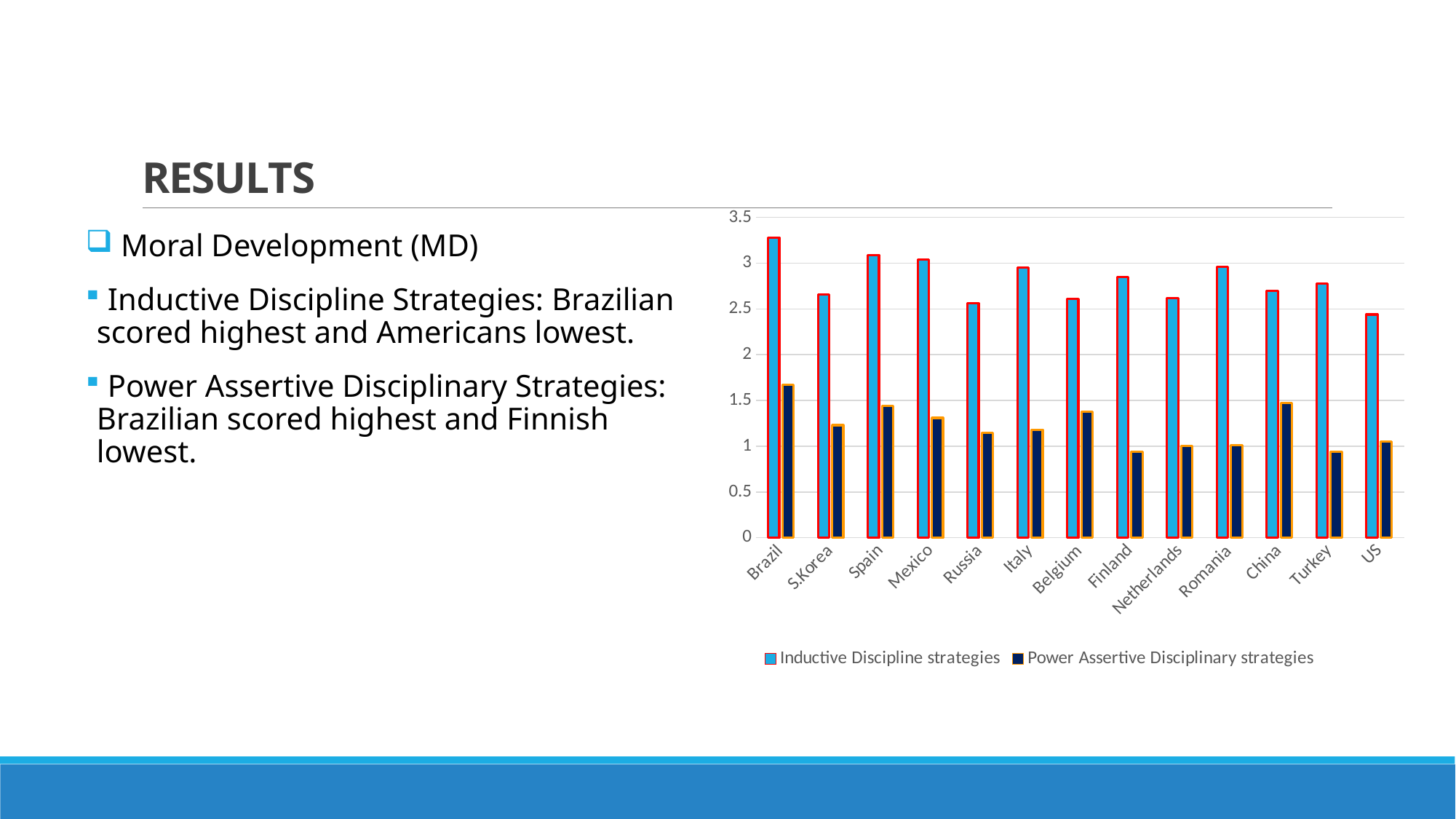
How many series does the legend list? 2 Which country has the larger Power Assertive Disciplinary strategies value, China or S.Korea? China Which is larger for China: the Inductive Discipline strategies value or the Power Assertive Disciplinary strategies value? Inductive Discipline strategies Is the Inductive Discipline strategies value for Brazil greater or less than 3? greater Which country has the lowest value for Inductive Discipline strategies? US How many countries are shown on the x axis of the chart? 13 Which country has the highest value for Inductive Discipline strategies? Brazil What kind of chart is shown on the slide? Bar chart Which country has the highest value for Power Assertive Disciplinary strategies? Brazil Is the Inductive Discipline strategies value for the US greater or less than 2.5? less Is the Power Assertive Disciplinary strategies value for Finland greater or less than 1? less